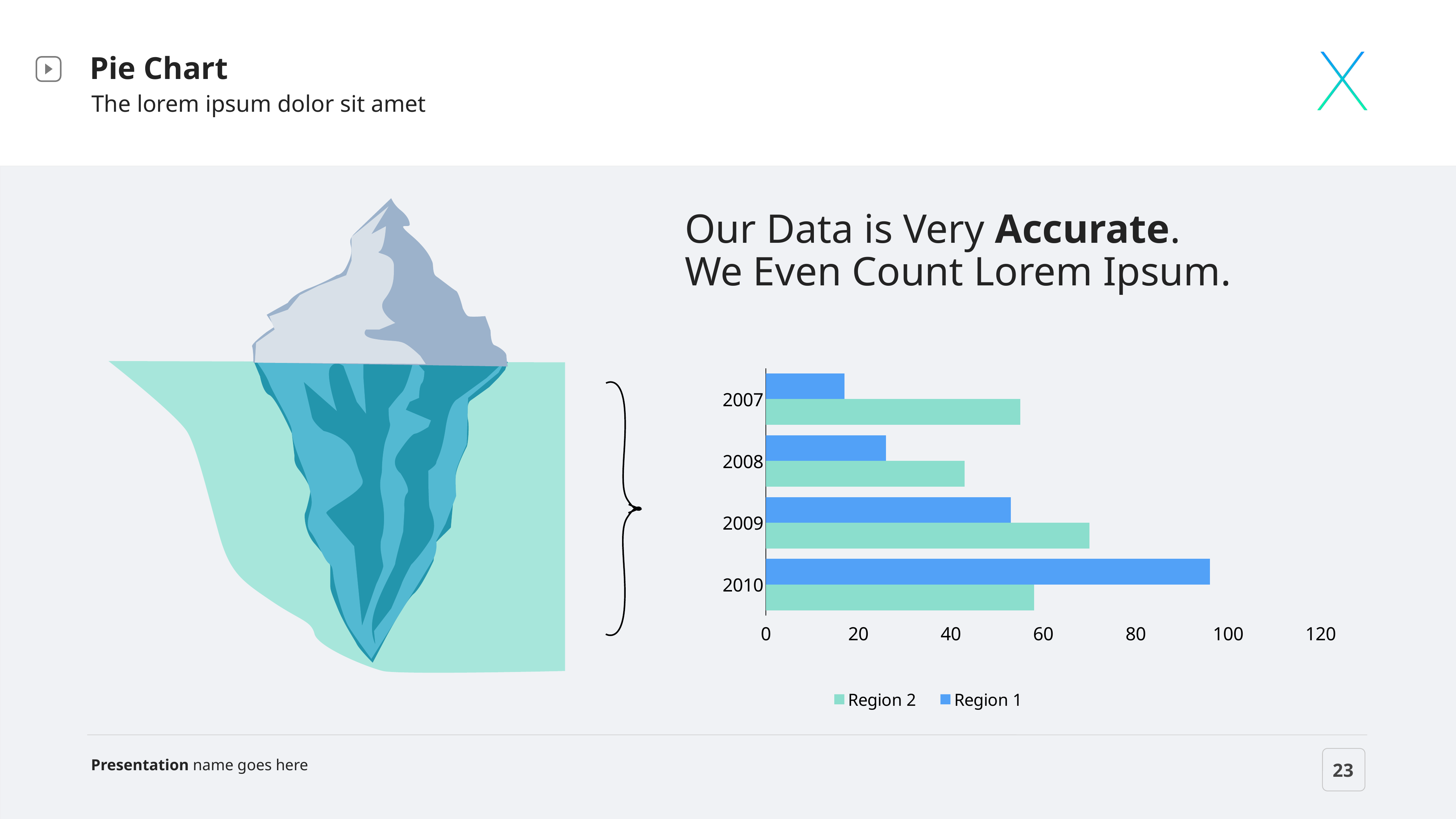
Which year has the highest value for Region 2? 2009 Is the value for Region 1 in 2010 greater or less than 80? greater Which year has the lowest value for Region 2? 2008 What kind of chart is shown on the slide? bar chart Which year has the highest value for Region 1? 2010 Which year has the lowest value for Region 1? 2007 Which colour represents Region 1 in the chart? blue How many years are shown on the chart's vertical axis? 4 How many series does the chart's legend list? 2 In 2007, which series has the larger value, Region 1 or Region 2? Region 2 In 2010, which series has the larger value, Region 1 or Region 2? Region 1 Do the Region 1 values rise or fall from 2007 to 2010? rise